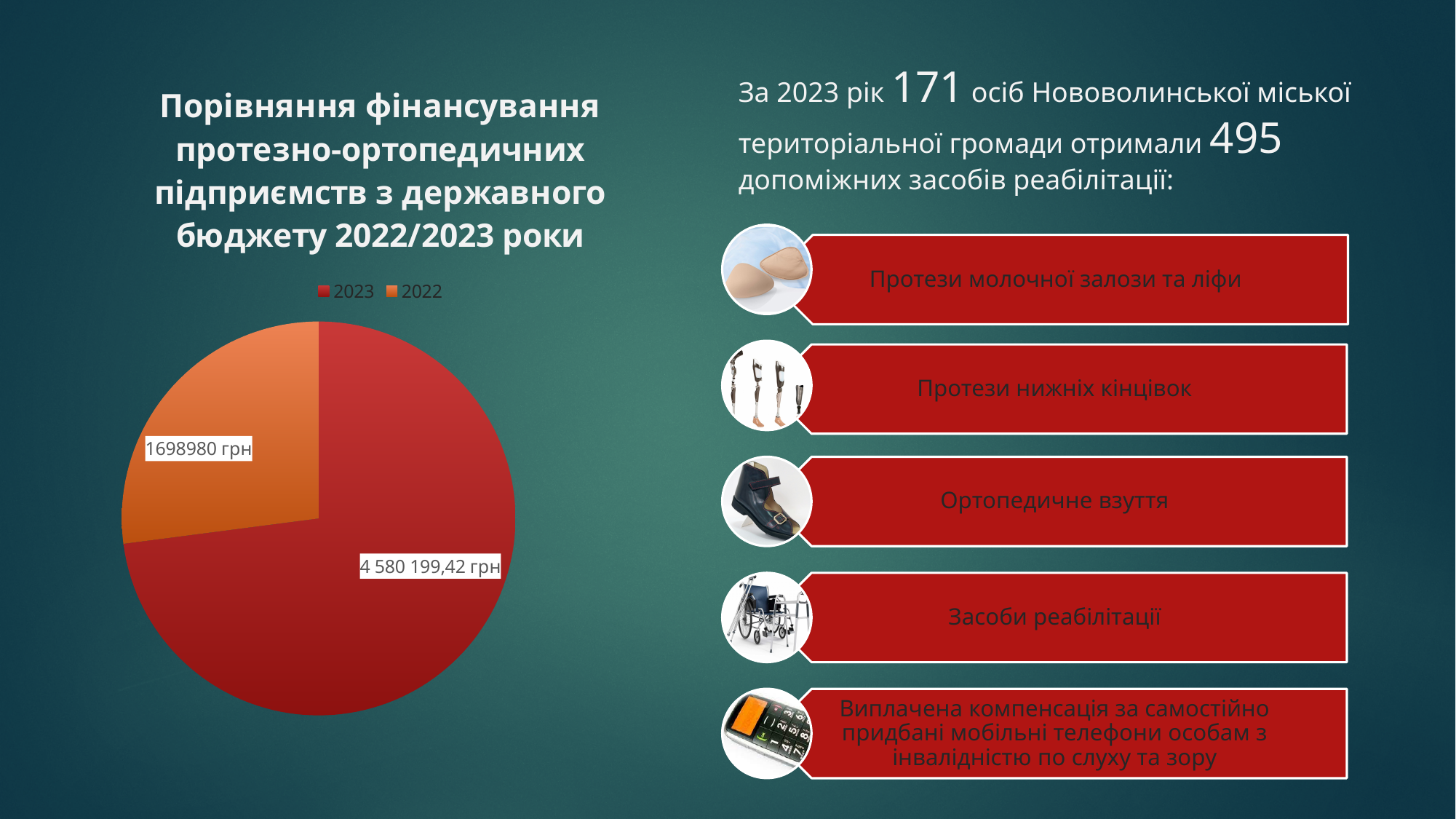
What is the value shown for 2023 in the pie chart? 4 580 199,42 грн What is the combined total of the two slices in the pie chart? 6 279 179,42 грн Which year has the smaller slice in the pie chart? 2022 What colour is the 2022 slice in the pie chart? Orange How many slices does the pie chart have? 2 Which year has the larger slice in the pie chart? 2023 What is the value shown for 2022 in the pie chart? 1698980 грн What kind of chart is shown on the left of the slide? Pie chart How many entries does the legend of the pie chart list? 2 By how much does the 2023 value exceed the 2022 value in the pie chart? 2 881 219,42 грн What is the title of the pie chart? Порівняння фінансування протезно-ортопедичних підприємств з державного бюджету 2022/2023 роки Is the funding for 2023 larger or smaller than the funding for 2022 in the pie chart? Larger